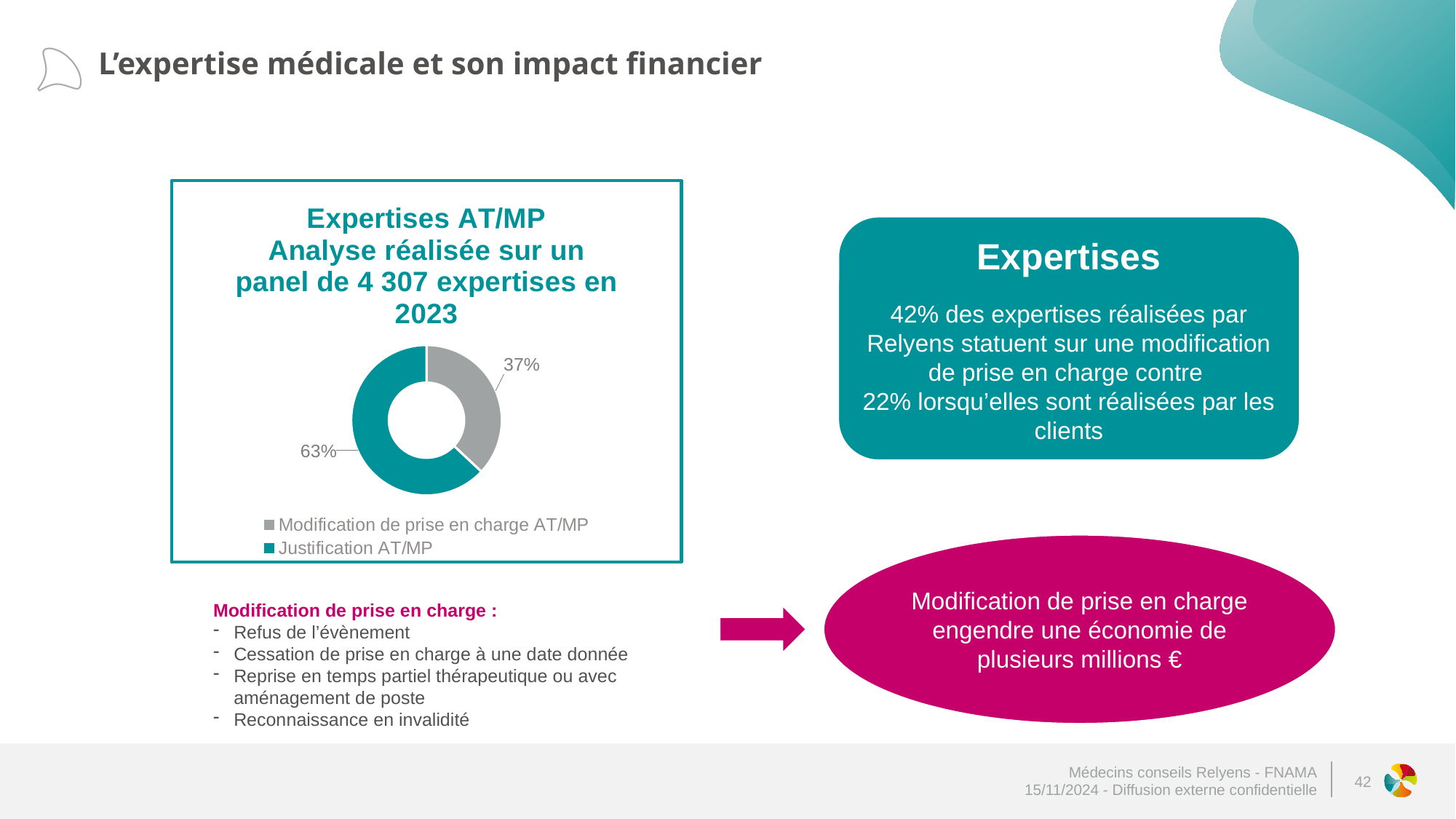
Which category has the smallest share in the chart? Modification de prise en charge AT/MP How many categories does the chart show? 2 What colour represents Justification AT/MP in the chart? Teal What is the title of the chart? Expertises AT/MP Analyse réalisée sur un panel de 4 307 expertises en 2023 What kind of chart is shown on the slide? Doughnut chart What percentage does the chart show for Justification AT/MP? 63% Which is larger: the share for Justification AT/MP or the share for Modification de prise en charge AT/MP? Justification AT/MP What is the total of the two percentages shown in the chart? 100% How many expertises were in the panel analysed in the chart? 4 307 What is the difference in percentage points between Justification AT/MP and Modification de prise en charge AT/MP? 26 Which category has the largest share in the chart? Justification AT/MP What percentage does the chart show for Modification de prise en charge AT/MP? 37%